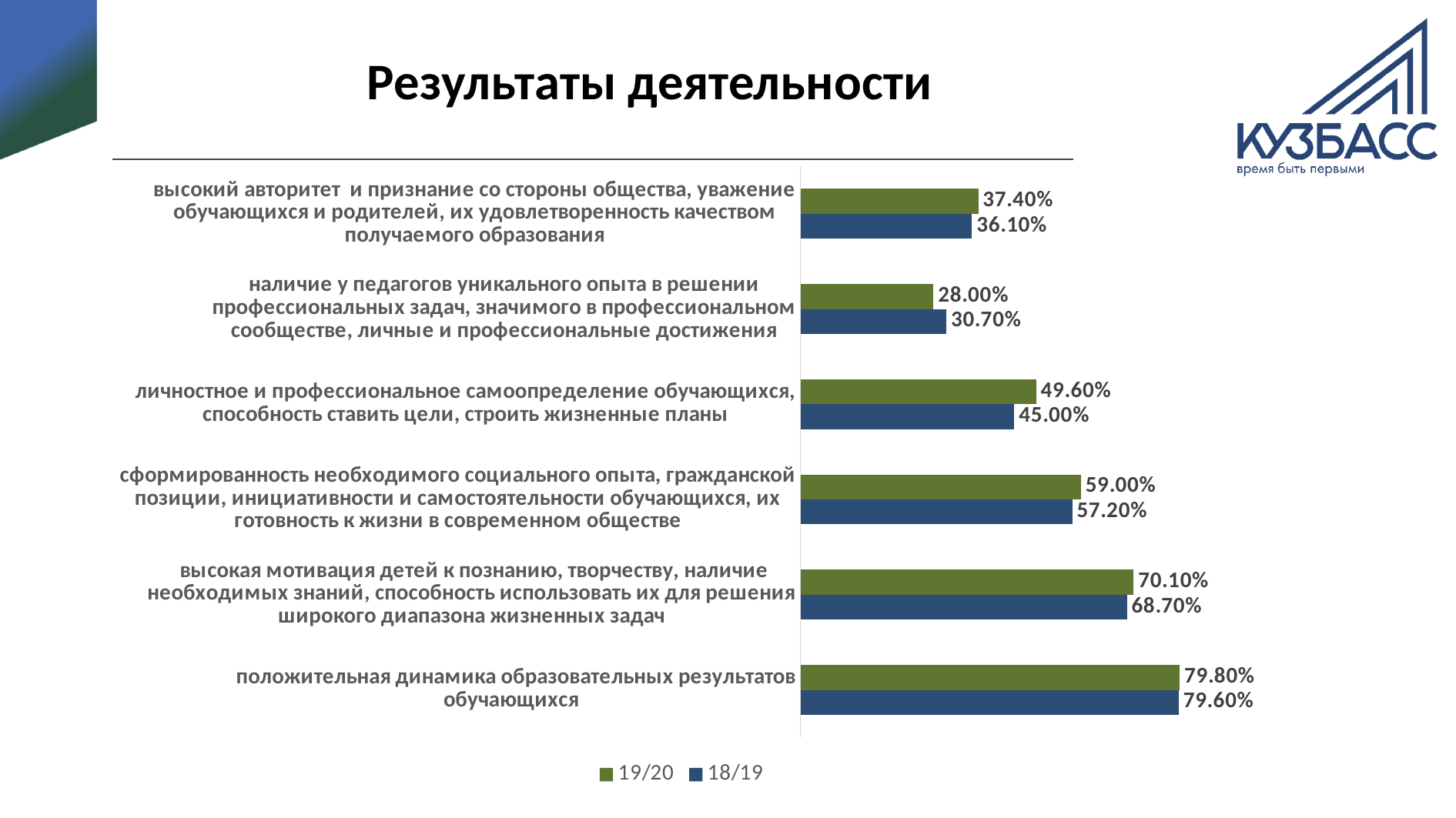
What is the 18/19 value for "наличие у педагогов уникального опыта в решении профессиональных задач..."? 30.70% Which category has the lowest 18/19 value? наличие у педагогов уникального опыта в решении профессиональных задач, значимого в профессиональном сообществе, личные и профессиональные достижения What is the difference between the 19/20 and 18/19 values for "высокая мотивация детей к познанию, творчеству..."? 1.40% How many categories are shown in the chart? 6 What is the 19/20 value for "личностное и профессиональное самоопределение обучающихся..."? 49.60% How many series does the legend list? 2 For "наличие у педагогов уникального опыта...", which series has the larger value, 19/20 or 18/19? 18/19 Which series is shown in green in the legend? 19/20 What is the title of the slide? Результаты деятельности Which category has the highest 19/20 value? положительная динамика образовательных результатов обучающихся What type of chart is shown on the slide? bar chart What is the 19/20 value for "положительная динамика образовательных результатов обучающихся"? 79.80%